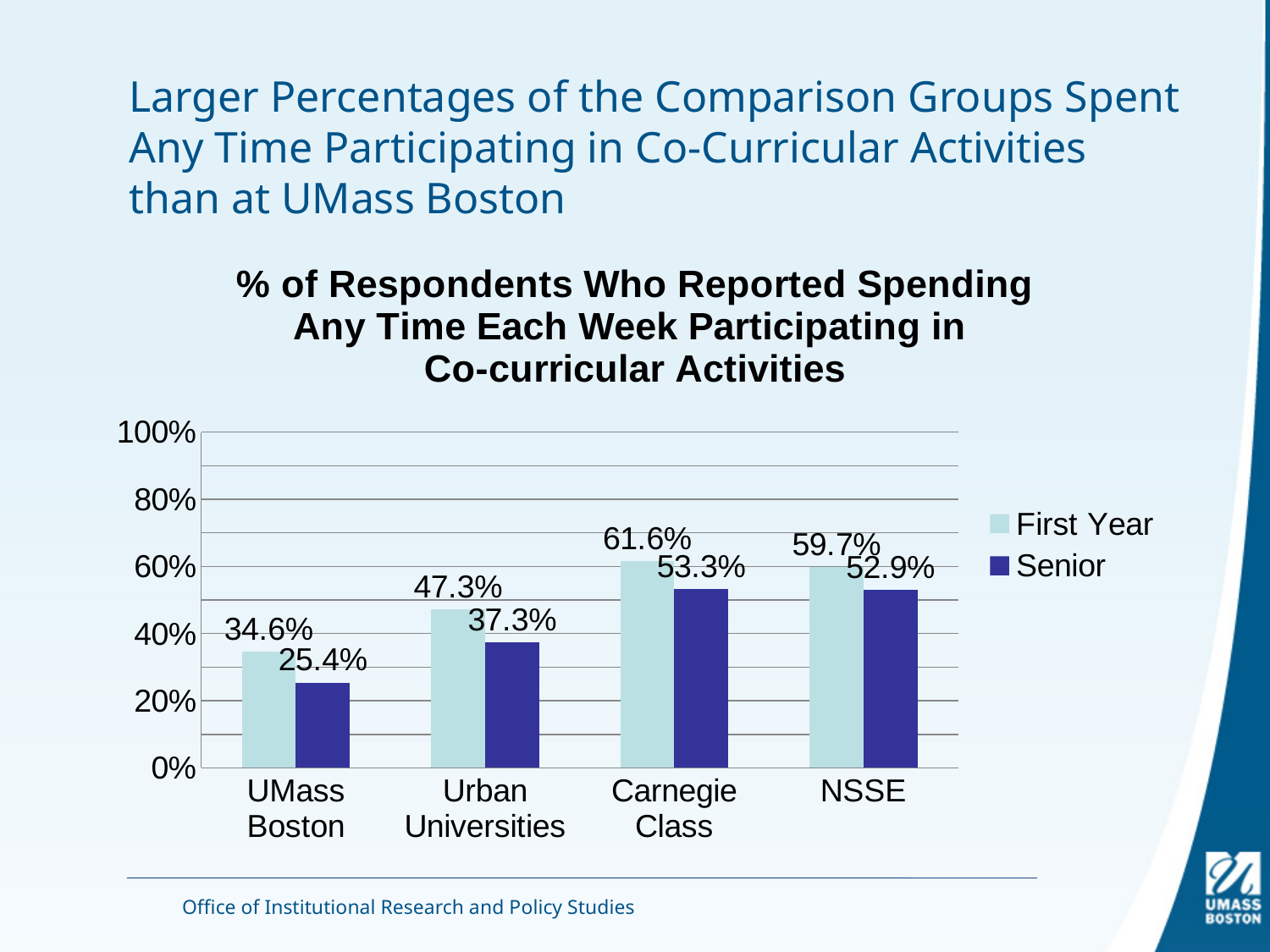
What is the Senior value for NSSE? 52.9% Is the Senior value for UMass Boston greater or less than 40%? less Which is larger: the First Year value for Urban Universities or the First Year value for NSSE? NSSE Which category has the highest First Year value? Carnegie Class What is the First Year value for UMass Boston? 34.6% What is the Senior value for Urban Universities? 37.3% Which category has the lowest Senior value? UMass Boston How many categories are shown on the x axis? 4 What is the difference between the First Year and Senior values for Carnegie Class? 8.3% What kind of chart is shown? bar chart How many series does the legend list? 2 Which series is shown in dark blue? Senior